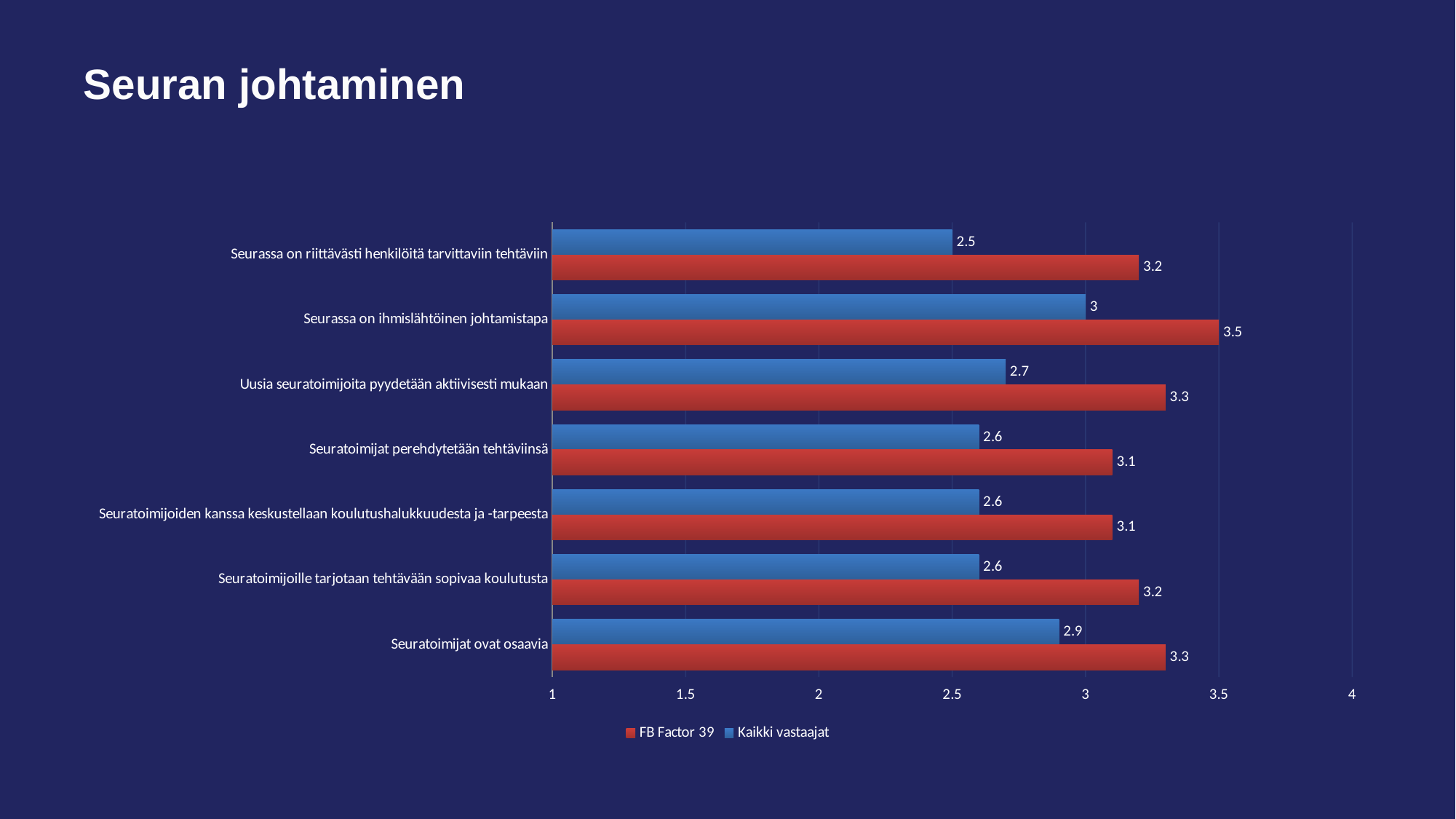
How many series does the legend list? 2 What is the Kaikki vastaajat value for "Seurassa on riittävästi henkilöitä tarvittaviin tehtäviin"? 2.5 Is the FB Factor 39 value for "Seuratoimijat perehdytetään tehtäviinsä" greater or less than 3? greater How many categories are shown on the chart? 7 What is the Kaikki vastaajat value for "Seuratoimijat ovat osaavia"? 2.9 Which category has the highest FB Factor 39 value? Seurassa on ihmislähtöinen johtamistapa What colour are the bars for the FB Factor 39 series? Red For "Uusia seuratoimijoita pyydetään aktiivisesti mukaan", which series has the larger value, FB Factor 39 or Kaikki vastaajat? FB Factor 39 What is the FB Factor 39 value for "Seurassa on ihmislähtöinen johtamistapa"? 3.5 What is the difference between the FB Factor 39 and Kaikki vastaajat values for "Seurassa on riittävästi henkilöitä tarvittaviin tehtäviin"? 0.7 Which category has the lowest Kaikki vastaajat value? Seurassa on riittävästi henkilöitä tarvittaviin tehtäviin What kind of chart is shown on the slide? Bar chart